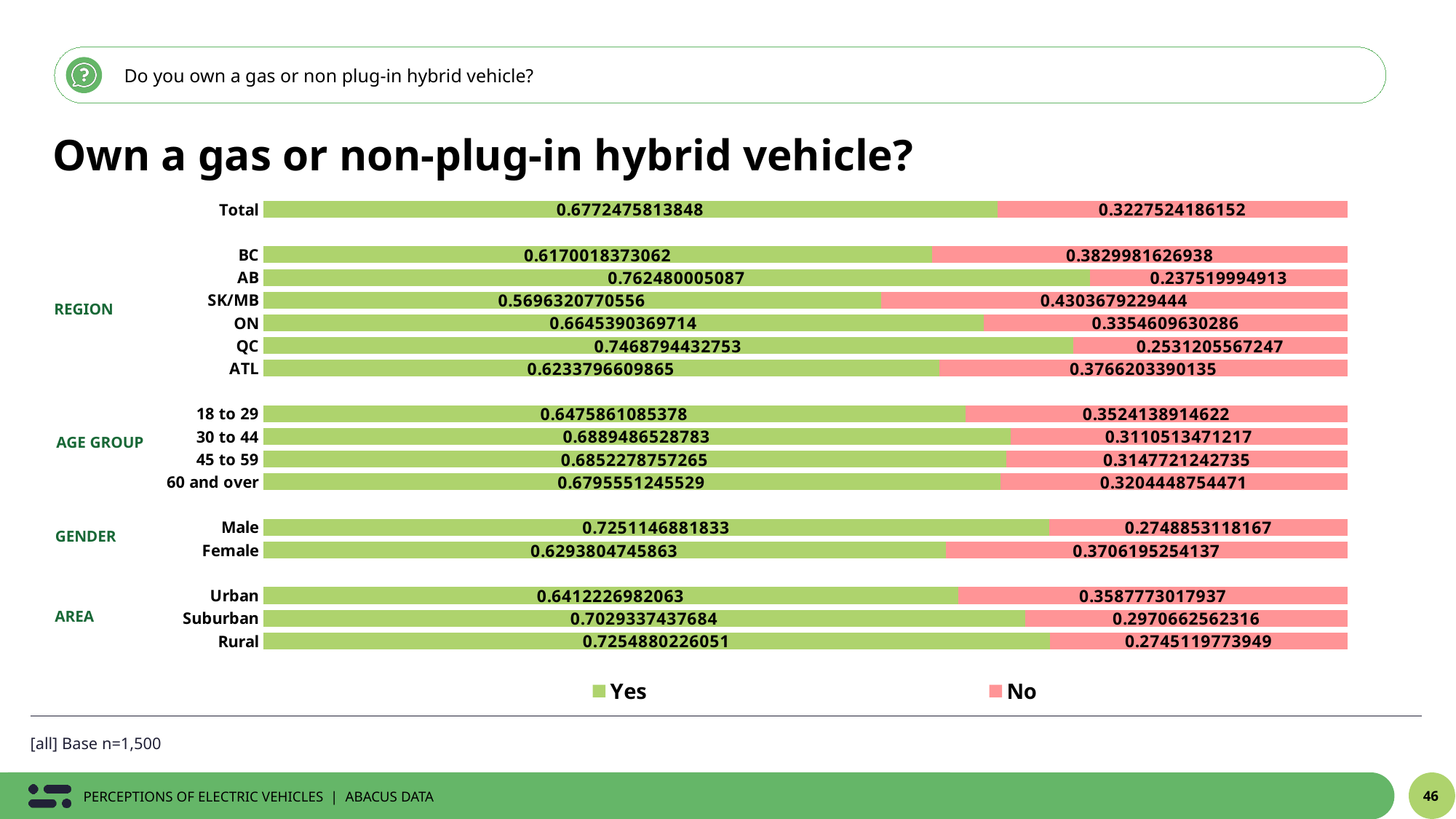
Which category has the highest Yes value? AB Which category has the lowest Yes value? SK/MB How many series does the legend list? 2 What is the Yes value for AB? 0.762480005087 What is the Yes value for the Total row? 0.6772475813848 What kind of chart is shown on the slide? Stacked bar chart What is the total of the Yes and No segments for the Total bar? 1 Which has a larger Yes value, Urban or Suburban? Suburban How many categories (bars) are shown in the chart, including Total? 16 What is the difference between the Yes values for Male and Female? 0.095734213597 What is the No value for Female? 0.3706195254137 Which category has the highest No value? SK/MB